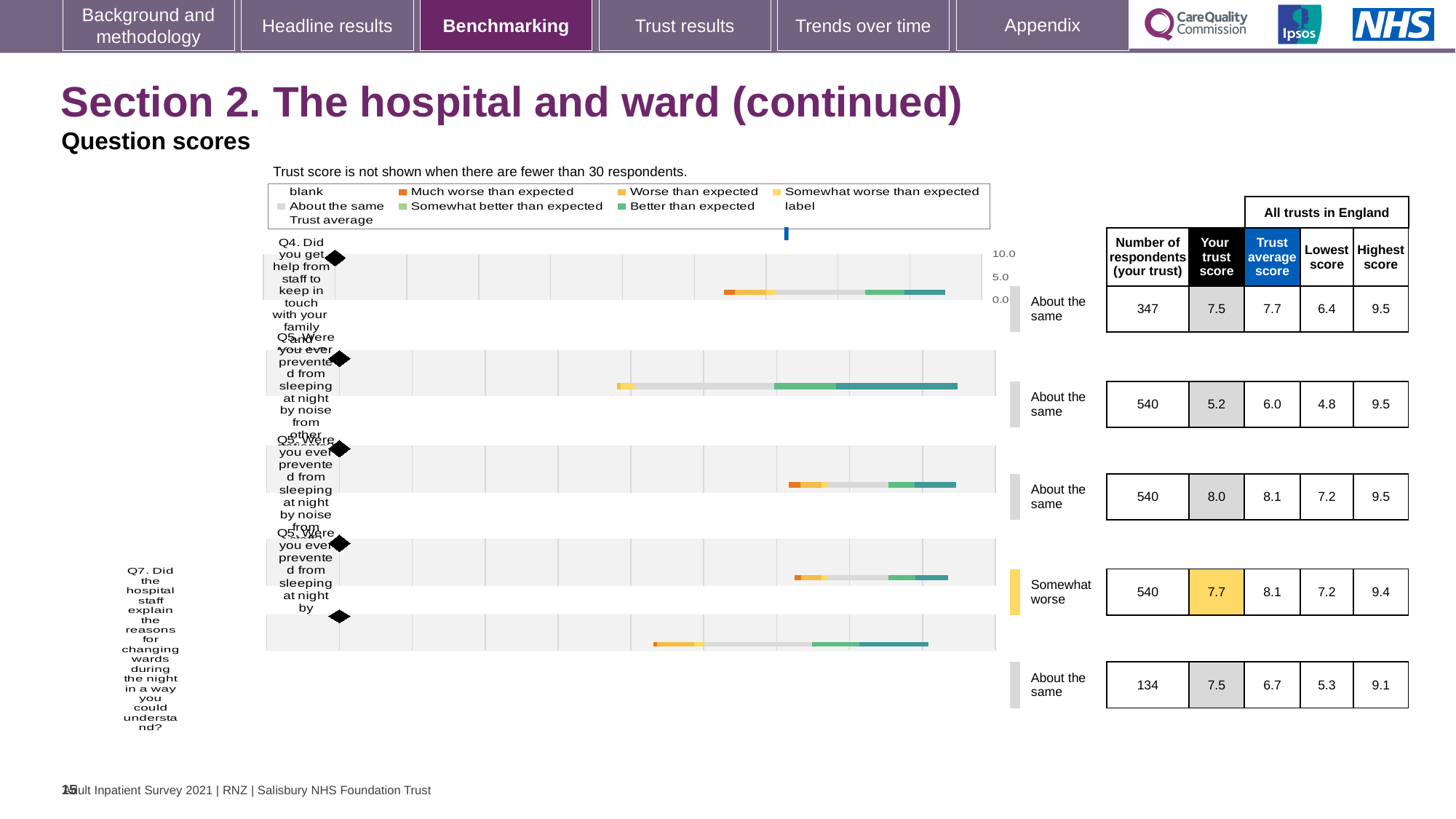
Which row has the lowest 'Your trust score' in the table beside the chart? the second row (5.2) Which row has the highest 'Your trust score' in the table beside the chart? the third row (8.0) What note is printed above the chart legend about when the trust score is not shown? Trust score is not shown when there are fewer than 30 respondents. In the table beside the chart, what is the number of respondents for the last row (Q7)? 134 In the table beside the chart, what is the number of respondents for the first row (Q4)? 347 Which row is rated 'Somewhat worse' rather than 'About the same'? the fourth row In the table beside the chart, what is 'Your trust score' for the first row (Q4)? 7.5 For the first row (Q4), is 'Your trust score' higher or lower than the 'Trust average score'? lower How many question rows (bars) are plotted in the benchmarking chart? 5 What kind of chart is used to show the question scores on this slide? bar chart What is the highest score shown for the last row (Q7) in the table beside the chart? 9.1 For the second row, what is the difference between the trust average score (6.0) and your trust score (5.2)? 0.8